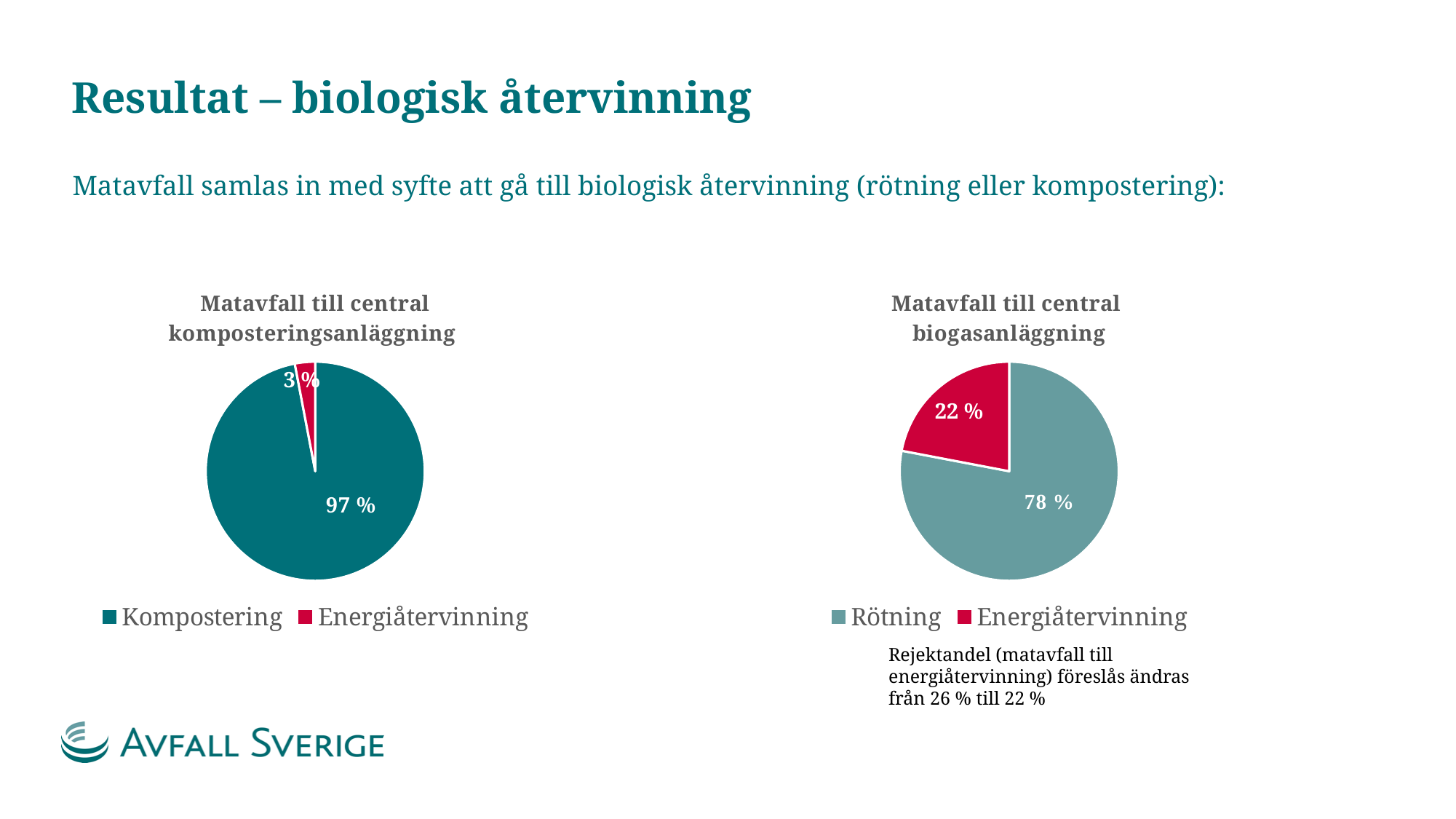
What are the legend entries of the 'Matavfall till central biogasanläggning' chart? Rötning, Energiåtervinning Which is larger: the Energiåtervinning share in the komposteringsanläggning chart or the Energiåtervinning share in the biogasanläggning chart? biogasanläggning In the 'Matavfall till central biogasanläggning' chart, what share does Rötning have? 78 % In the 'Matavfall till central komposteringsanläggning' chart, what share does Kompostering have? 97 % In the 'Matavfall till central biogasanläggning' chart, which slice is the largest? Rötning In the 'Matavfall till central komposteringsanläggning' chart, which slice is the smallest? Energiåtervinning In the 'Matavfall till central biogasanläggning' chart, what share does Energiåtervinning have? 22 % In the 'Matavfall till central komposteringsanläggning' chart, what share does Energiåtervinning have? 3 % In the 'Matavfall till central komposteringsanläggning' chart, what colour is the Energiåtervinning slice? red How many slices does the 'Matavfall till central biogasanläggning' chart have? 2 In the 'Matavfall till central biogasanläggning' chart, what is the difference between the Rötning and Energiåtervinning shares? 56 % What type of chart is 'Matavfall till central komposteringsanläggning'? pie chart